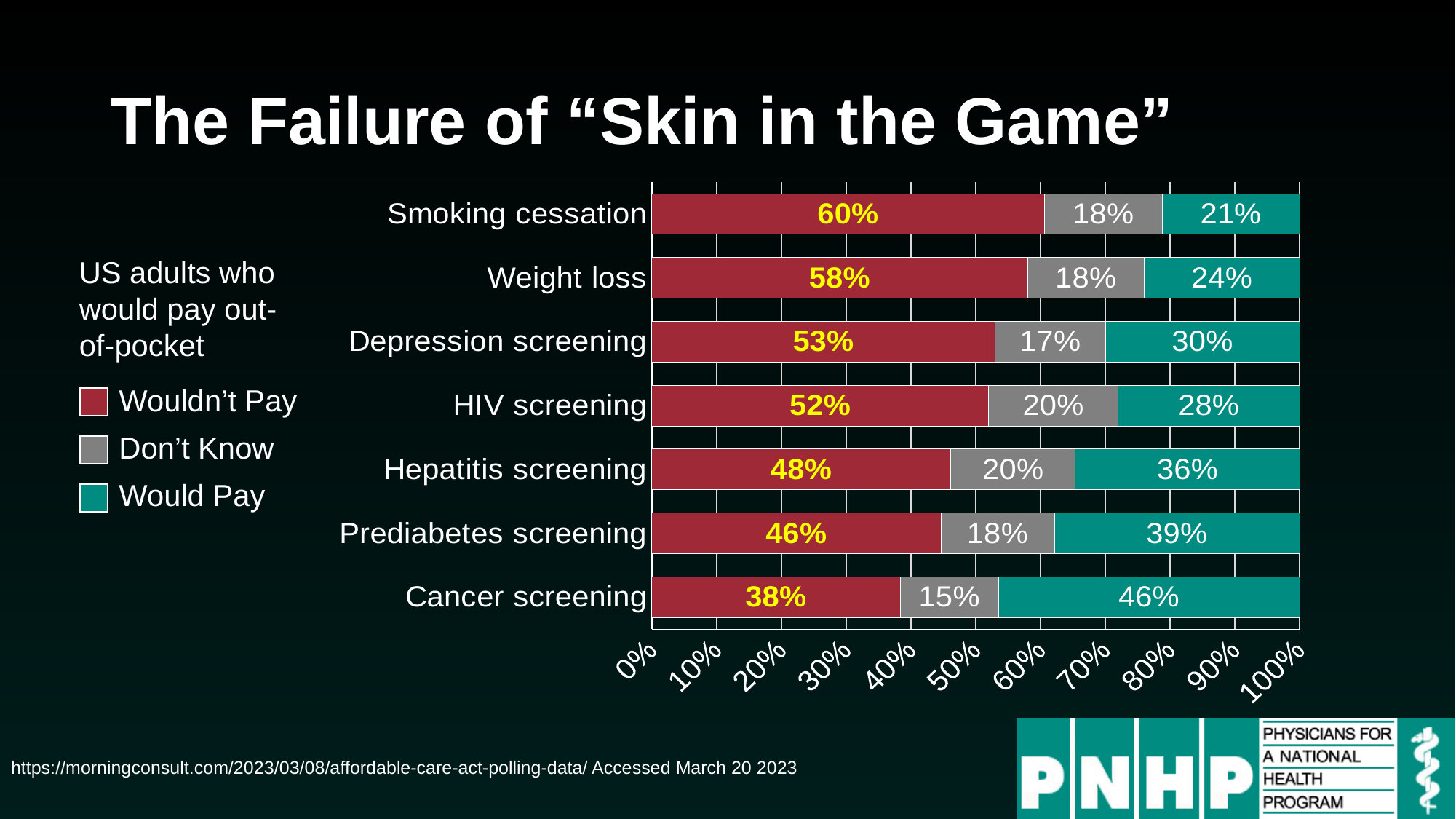
How many services are listed on the chart? 7 What percentage of US adults wouldn't pay out-of-pocket for smoking cessation? 60% What kind of chart is shown on the slide? Stacked bar chart How many series does the legend list? 3 What percentage of US adults would pay out-of-pocket for cancer screening? 46% What is the difference between the Wouldn't Pay percentages for weight loss and cancer screening? 20% Which colour represents the Would Pay series in the legend? Teal Which service has the lowest Would Pay percentage? Smoking cessation Which is larger: the Would Pay percentage for hepatitis screening or for depression screening? Hepatitis screening What is the total of the three segments for the prediabetes screening bar? 103% What is the Don't Know percentage for HIV screening? 20% Which service has the highest Wouldn't Pay percentage? Smoking cessation